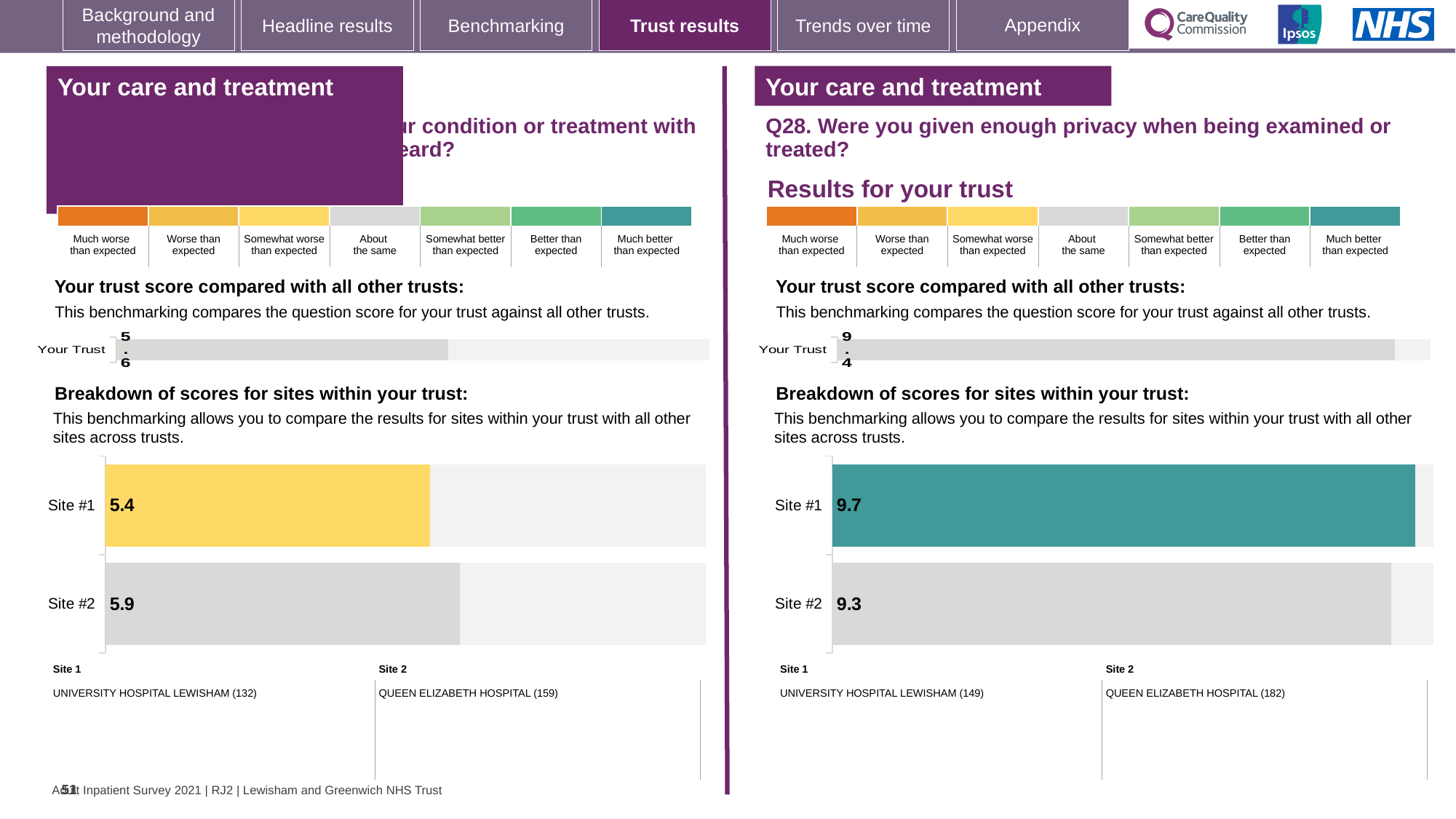
In the left-hand 'Breakdown of scores for sites within your trust' chart, what is the score for Site #2? 5.9 In the left-hand site breakdown chart, which site has the higher score? Site #2 In the right-hand (Q28) 'Your trust score compared with all other trusts' chart, what is the score shown for Your Trust? 9.4 In the left-hand 'Your trust score compared with all other trusts' chart, what is the score shown for Your Trust? 5.6 In the right-hand (Q28) site breakdown chart, which site has the lower score? Site #2 In the right-hand (Q28) 'Breakdown of scores for sites within your trust' chart, what is the score for Site #2? 9.3 In the right-hand (Q28) 'Breakdown of scores for sites within your trust' chart, what is the score for Site #1? 9.7 How many sites are shown in the right-hand (Q28) site breakdown chart? 2 In the left-hand 'Breakdown of scores for sites within your trust' chart, what is the score for Site #1? 5.4 What type of chart is used for the site breakdown on the left-hand side of the slide? Bar chart In the right-hand (Q28) site breakdown chart, what is the difference between the Site #1 and Site #2 scores? 0.4 In the left-hand site breakdown chart, what is the difference between the Site #2 and Site #1 scores? 0.5